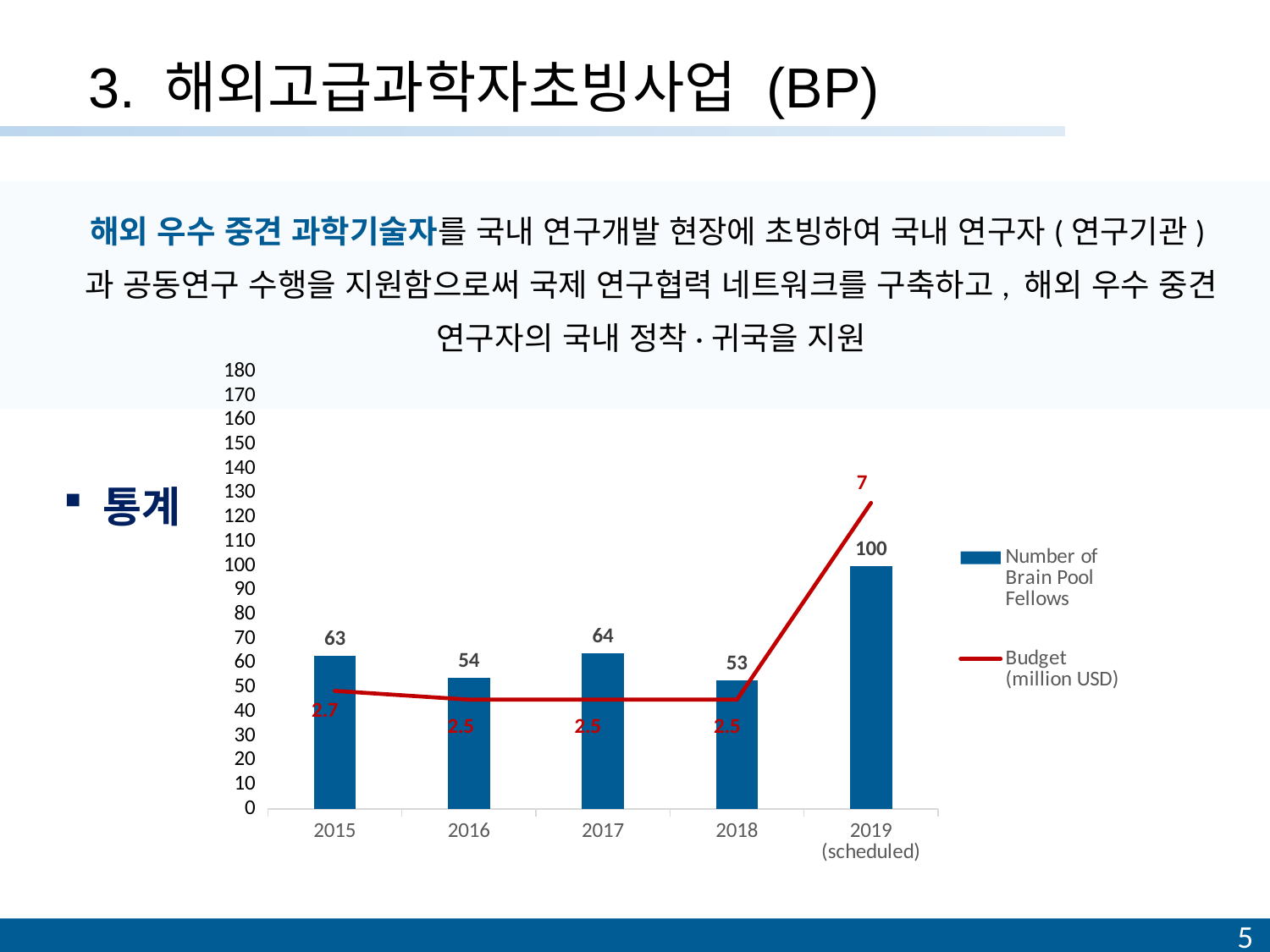
What is the Budget (million USD) in 2015? 2.7 What is the Number of Brain Pool Fellows scheduled for 2019? 100 Which year has the lowest Number of Brain Pool Fellows? 2018 What kind of chart is used to show the Number of Brain Pool Fellows? Bar chart How many series does the chart legend list? 2 Which year has the larger Number of Brain Pool Fellows, 2015 or 2016? 2015 What colour is the Budget (million USD) line in the chart? Red What is the difference in the Number of Brain Pool Fellows between 2019 (scheduled) and 2018? 47 Which year has the highest Number of Brain Pool Fellows? 2019 (scheduled) What is the Budget (million USD) in 2019 (scheduled)? 7 How many years are shown on the x axis of the chart? 5 What is the Number of Brain Pool Fellows in 2017? 64